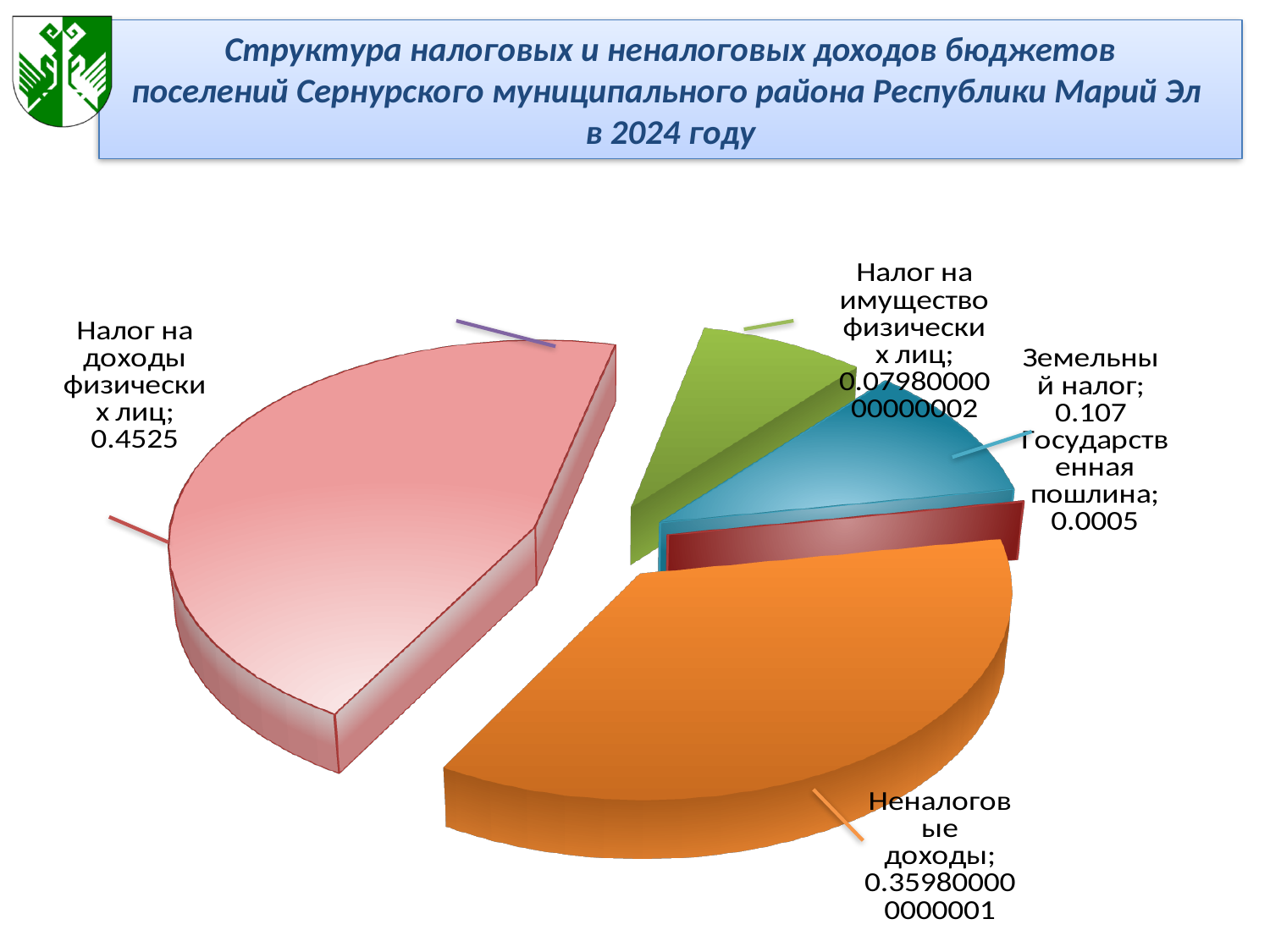
What is the value shown for Государственная пошлина? 0.0005 How many slices does the pie chart have? 5 What is the difference between the values for Налог на доходы физических лиц and Земельный налог? 0.3455 Which category has the smallest slice of the pie? Государственная пошлина Which is larger: Земельный налог or Налог на имущество физических лиц? Земельный налог What is the value shown for Земельный налог? 0.107 Which category has the largest slice of the pie? Налог на доходы физических лиц What is the value shown for Неналоговые доходы? 0.359800000000001 What kind of chart is shown on the slide? pie chart What is the difference between the values for Земельный налог and Государственная пошлина? 0.1065 Which year does the chart title say the data refers to? 2024 What is the value shown for Налог на доходы физических лиц? 0.4525